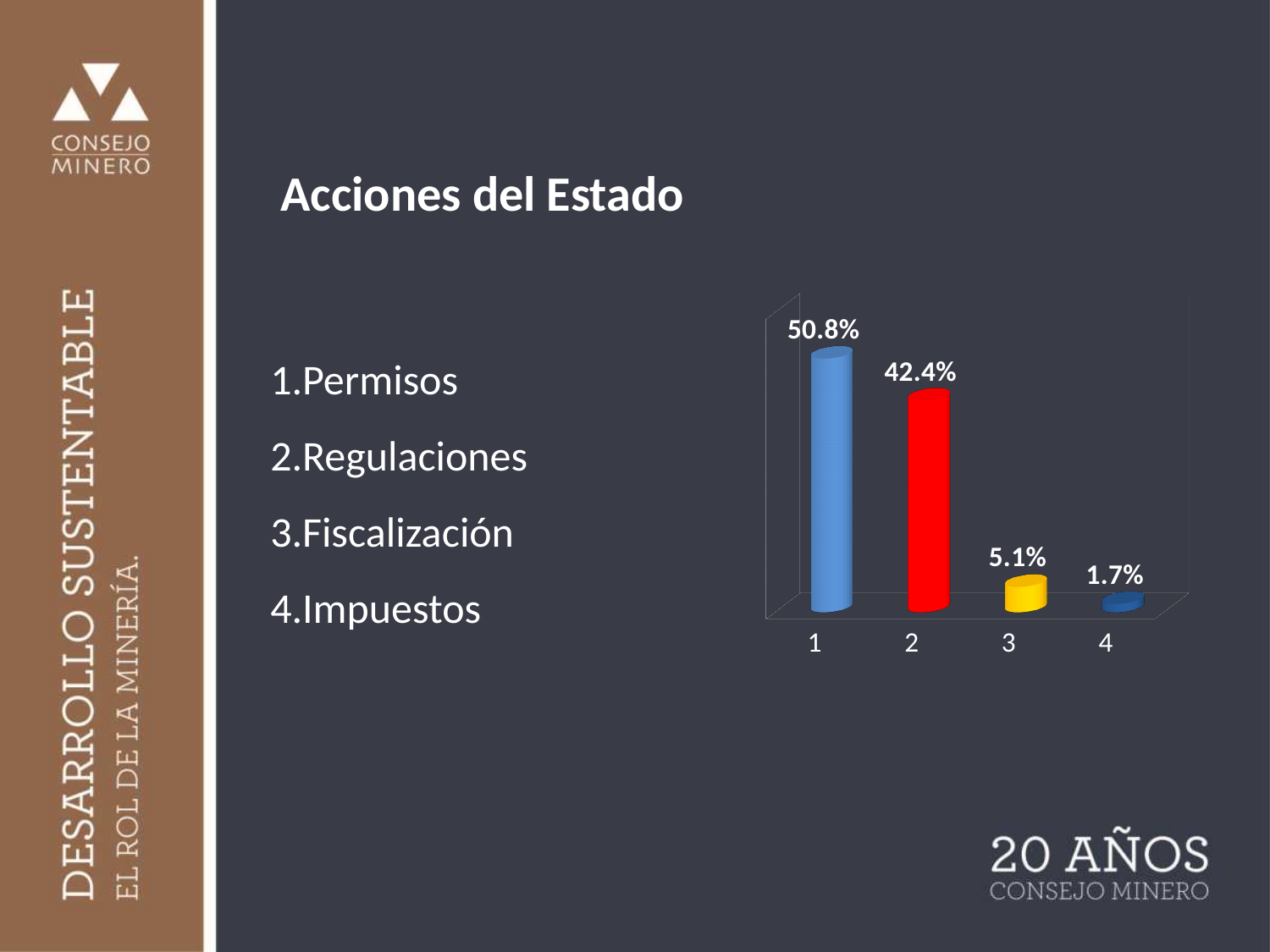
Which is larger, the value for category 2 or the value for category 3? Category 2 What is the value shown for category 4 (Impuestos) in the chart? 1.7% Which category has the lowest value in the chart? 4 (Impuestos) What is the difference between the values for category 3 and category 4? 3.4% How many bars are plotted in the chart? 4 What is the difference between the values for category 1 and category 2? 8.4% What is the value shown for category 1 (Permisos) in the chart? 50.8% What kind of chart is shown on the slide? Bar chart What is the value shown for category 3 (Fiscalización) in the chart? 5.1% What is the value shown for category 2 (Regulaciones) in the chart? 42.4% Which category has the highest value in the chart? 1 (Permisos) Do the values rise or fall from category 1 to category 4? Fall